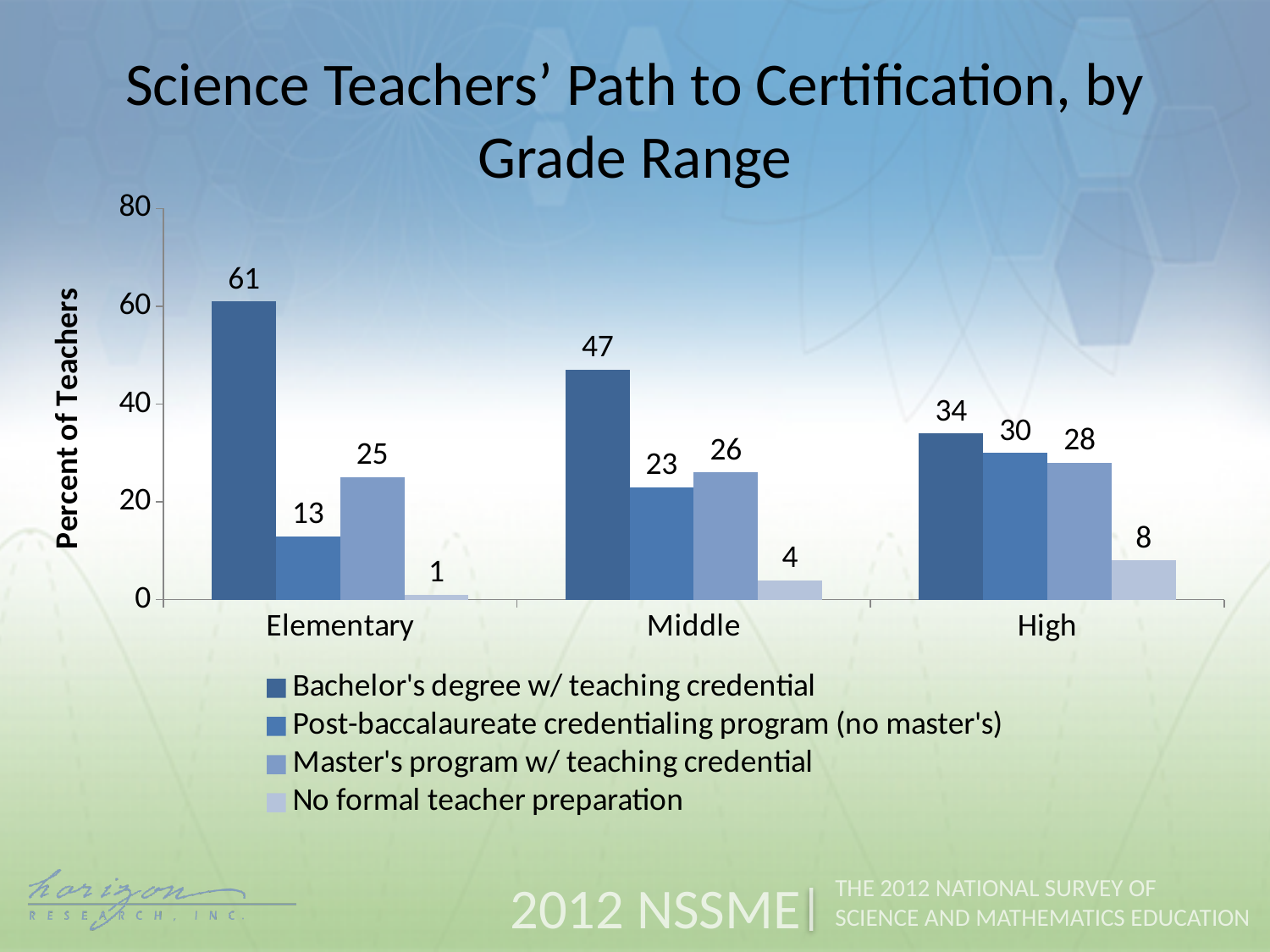
What is the label of the y axis? Percent of Teachers How many series does the legend list? 4 Which is larger for the Middle grade range: 'Post-baccalaureate credentialing program (no master's)' or 'Master's program w/ teaching credential'? Master's program w/ teaching credential Do the values for 'Bachelor's degree w/ teaching credential' rise or fall from Elementary to High? Fall How many grade ranges are shown on the x axis? 3 What is the value for 'Master's program w/ teaching credential' in the Middle grade range? 26 Which grade range has the lowest value for 'No formal teacher preparation'? Elementary What percent of elementary science teachers have a bachelor's degree with teaching credential? 61 Which grade range has the highest value for 'Bachelor's degree w/ teaching credential'? Elementary What kind of chart is shown on the slide? Bar chart What is the value for 'No formal teacher preparation' in the High grade range? 8 What is the difference between the 'Bachelor's degree w/ teaching credential' values for Elementary and High? 27